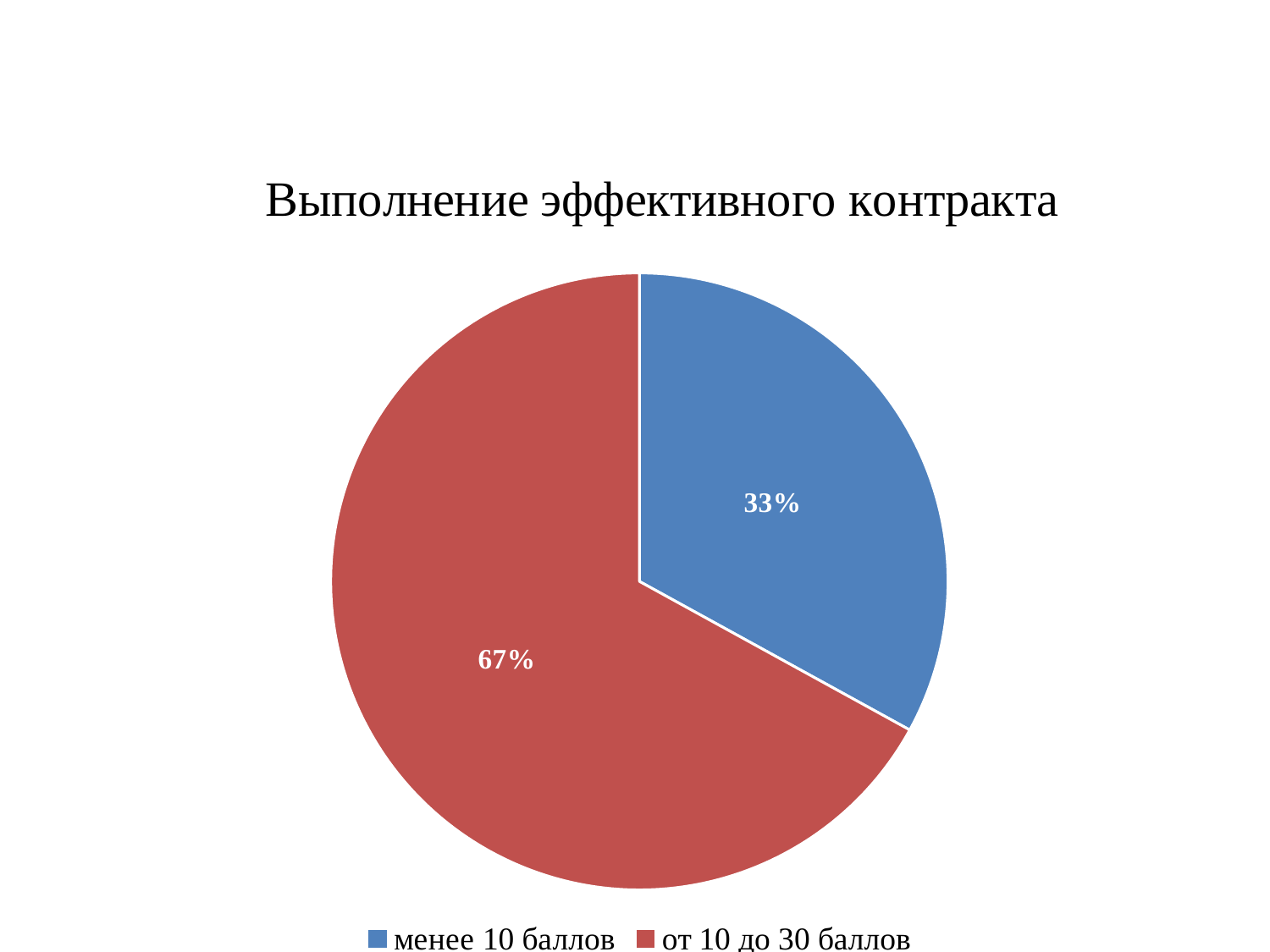
How many slices does the pie chart have? 2 What is the title of the chart? Выполнение эффективного контракта How many entries does the legend list? 2 Which slice is larger: "менее 10 баллов" or "от 10 до 30 баллов"? от 10 до 30 баллов What colour is the slice for "менее 10 баллов"? blue What share of the pie is labelled "менее 10 баллов"? 33% What kind of chart is shown on the slide? pie chart What share of the pie is labelled "от 10 до 30 баллов"? 67% Which category has the largest share of the pie? от 10 до 30 баллов What is the difference in percentage points between the "от 10 до 30 баллов" slice and the "менее 10 баллов" slice? 34 Which category has the smallest share of the pie? менее 10 баллов